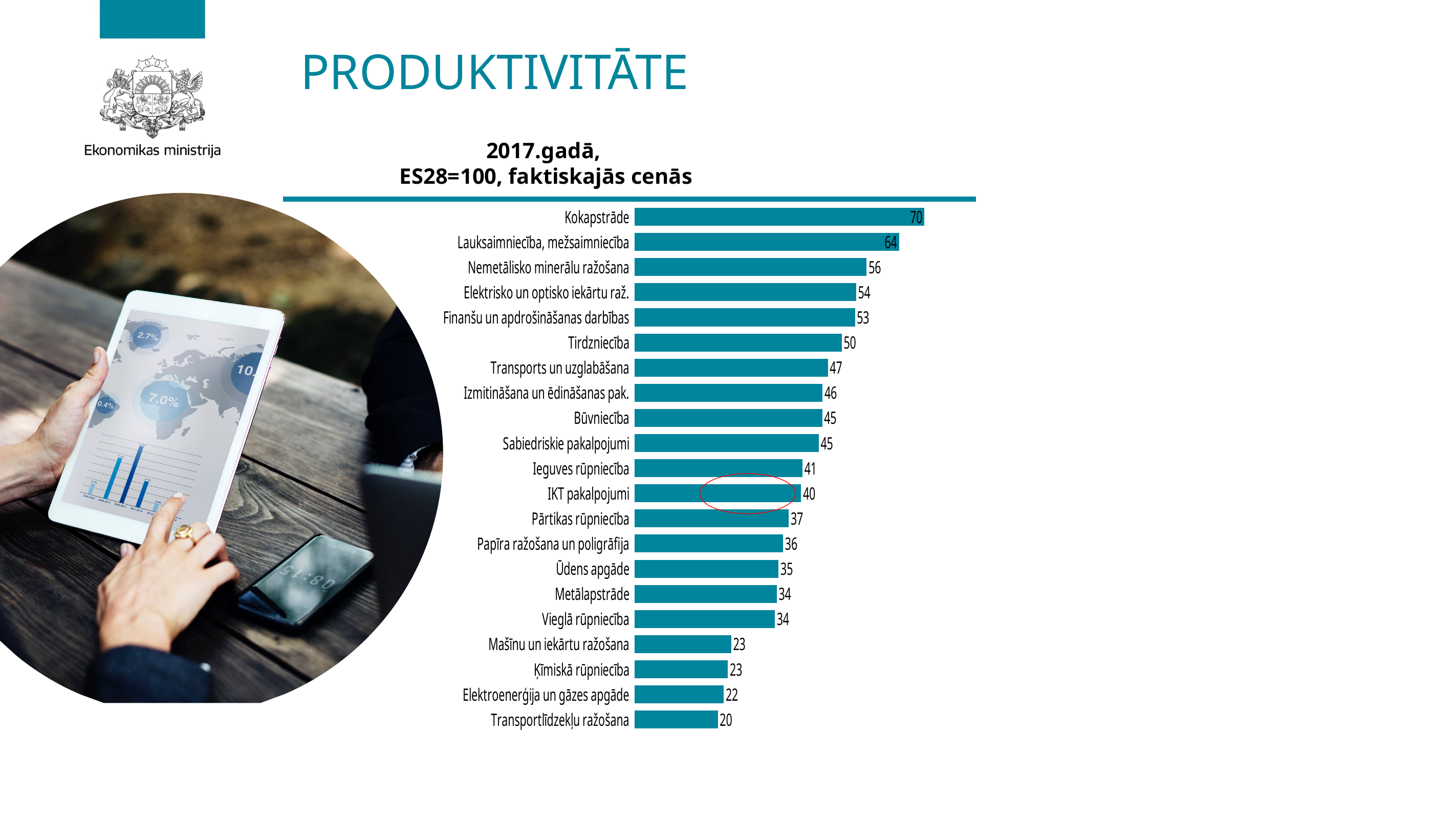
What is the value for IKT pakalpojumi? 40 What is the difference between the values for Kokapstrāde and Lauksaimniecība, mežsaimniecība? 6 Which category's bar is circled in red on the chart? IKT pakalpojumi What is the difference between the values for Tirdzniecība and Transportlīdzekļu ražošana? 30 How many categories are shown in the chart? 21 Which category has the highest value? Kokapstrāde Which is larger, the value for Būvniecība or the value for Pārtikas rūpniecība? Būvniecība Which category has the lowest value? Transportlīdzekļu ražošana What kind of chart is shown on the slide? Bar chart What is the value for Kokapstrāde? 70 What is the value for Elektroenerģija un gāzes apgāde? 22 What is the value for Tirdzniecība? 50